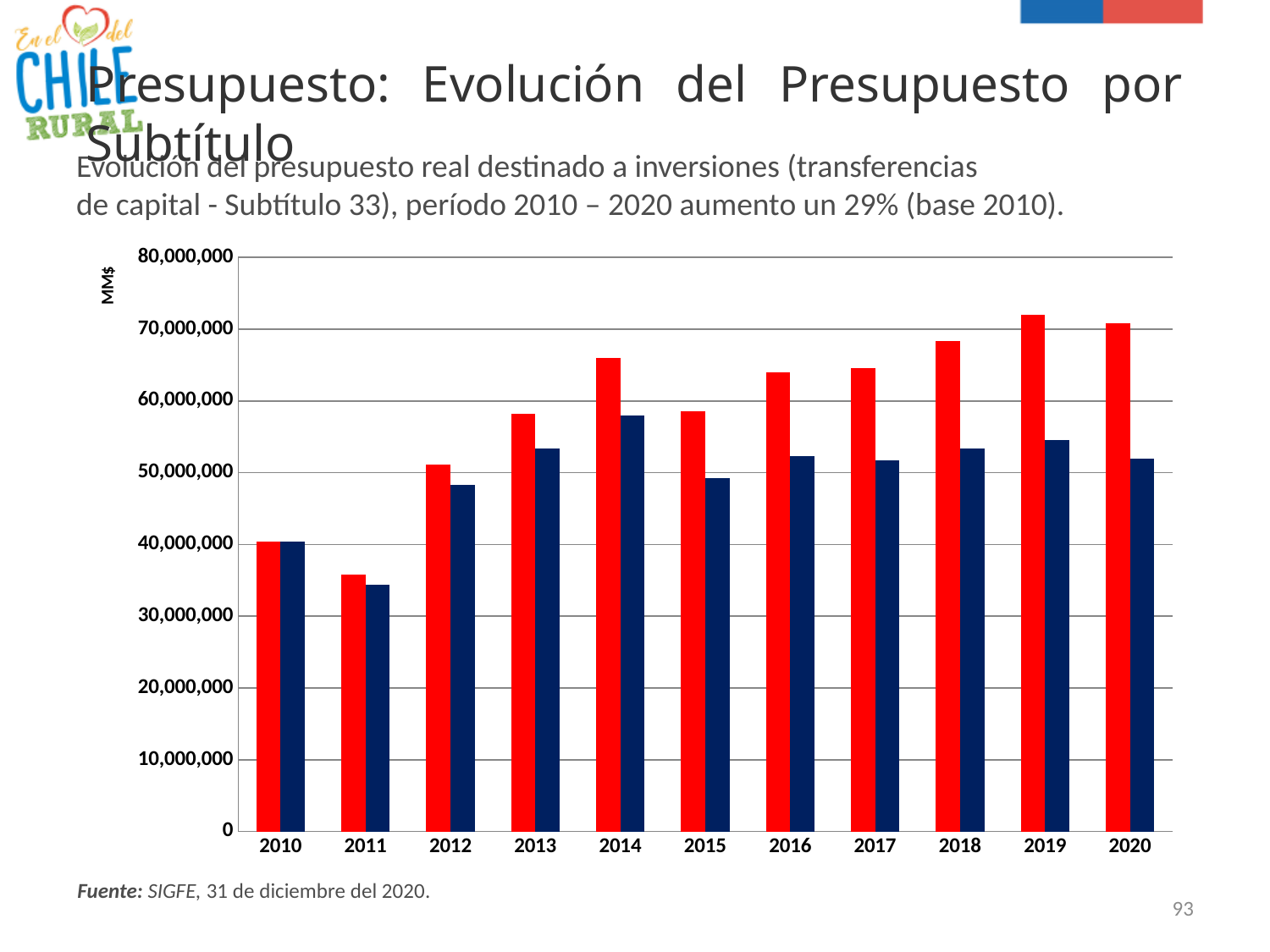
Is the value of the dark blue bar for 2012 greater or less than 50,000,000? less Which year has the shortest red bar? 2011 What unit label is shown on the vertical axis of the chart? MM$ Which year has the tallest dark blue bar? 2014 What kind of chart is shown on the slide? bar chart Is the value of the red bar for 2014 greater or less than 60,000,000? greater Do the red bars rise or fall from 2016 to 2019? rise How many years are shown on the x axis of the chart? 11 Which is larger, the red bar for 2014 or the red bar for 2015? 2014 Which year has the shortest dark blue bar? 2011 Which year has the tallest red bar? 2019 Is the value of the red bar for 2019 greater or less than 70,000,000? greater